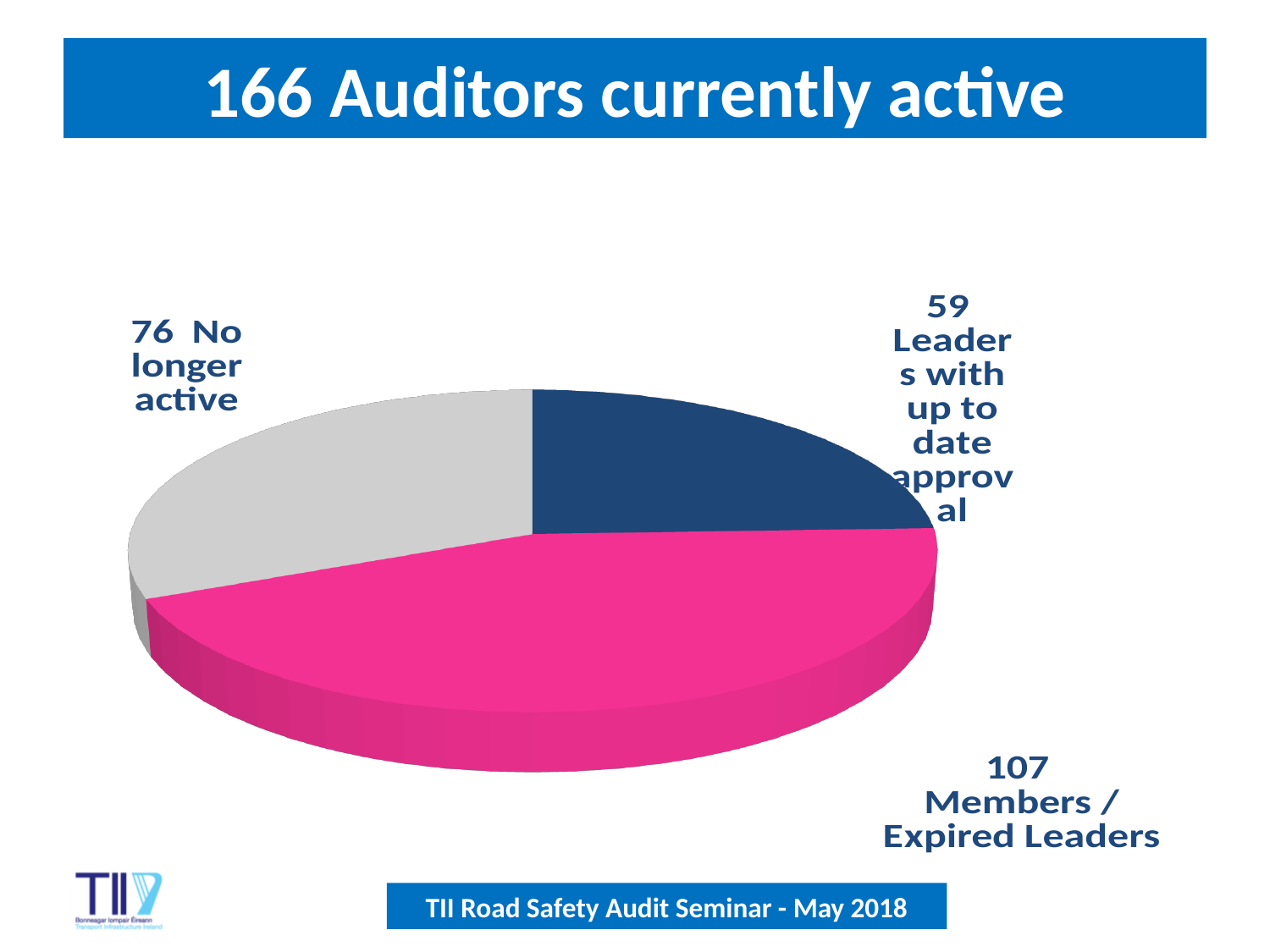
What kind of chart is shown on the slide? Pie chart Which category has the smallest slice of the pie? Leaders with up to date approval What colour is the 'Members / Expired Leaders' slice? Pink What is the title of the slide containing the pie chart? 166 Auditors currently active Which category has the largest slice of the pie? Members / Expired Leaders What is the value for the 'No longer active' slice? 76 What is the difference between the 'No longer active' value and the 'Leaders with up to date approval' value? 17 What is the value for the 'Members / Expired Leaders' slice? 107 Which is larger: the 'No longer active' slice or the 'Leaders with up to date approval' slice? No longer active What is the value for the 'Leaders with up to date approval' slice? 59 What is the difference between the 'Members / Expired Leaders' value and the 'No longer active' value? 31 How many slices does the pie chart have? 3